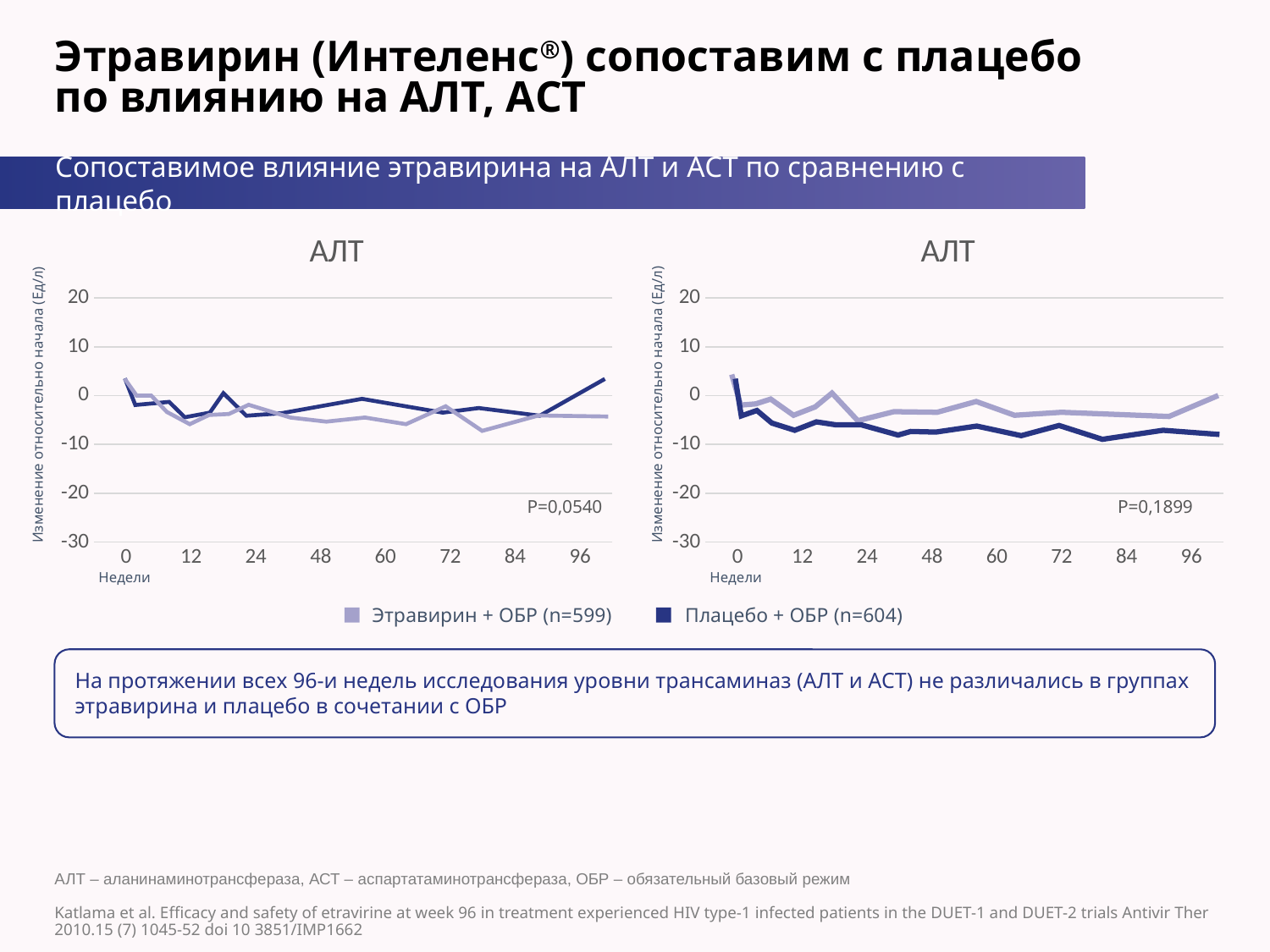
What kind of chart is the left chart on the slide? line chart What P-value is printed on the left chart? P=0,0540 How many week labels are shown on the x axis of the left chart? 8 In the right chart, at week 84, which series has the higher value: Этравирин + ОБР or Плацебо + ОБР? Этравирин + ОБР In the right chart, is the value for Плацебо + ОБР at week 96 greater or less than 0? less How many series does the legend list for the charts? 2 In the right chart, does the Плацебо + ОБР line generally rise or fall from week 0 to week 96? fall What P-value is printed on the right chart? P=0,1899 In the left chart, at week 96, which series has the higher value: Этравирин + ОБР or Плацебо + ОБР? Плацебо + ОБР What are the two series named in the legend? Этравирин + ОБР (n=599) and Плацебо + ОБР (n=604) What is the label of the y axis on the left chart? Изменение относительно начала (Ед/л) In the right chart, is the value for Плацебо + ОБР at week 48 greater or less than -10? greater